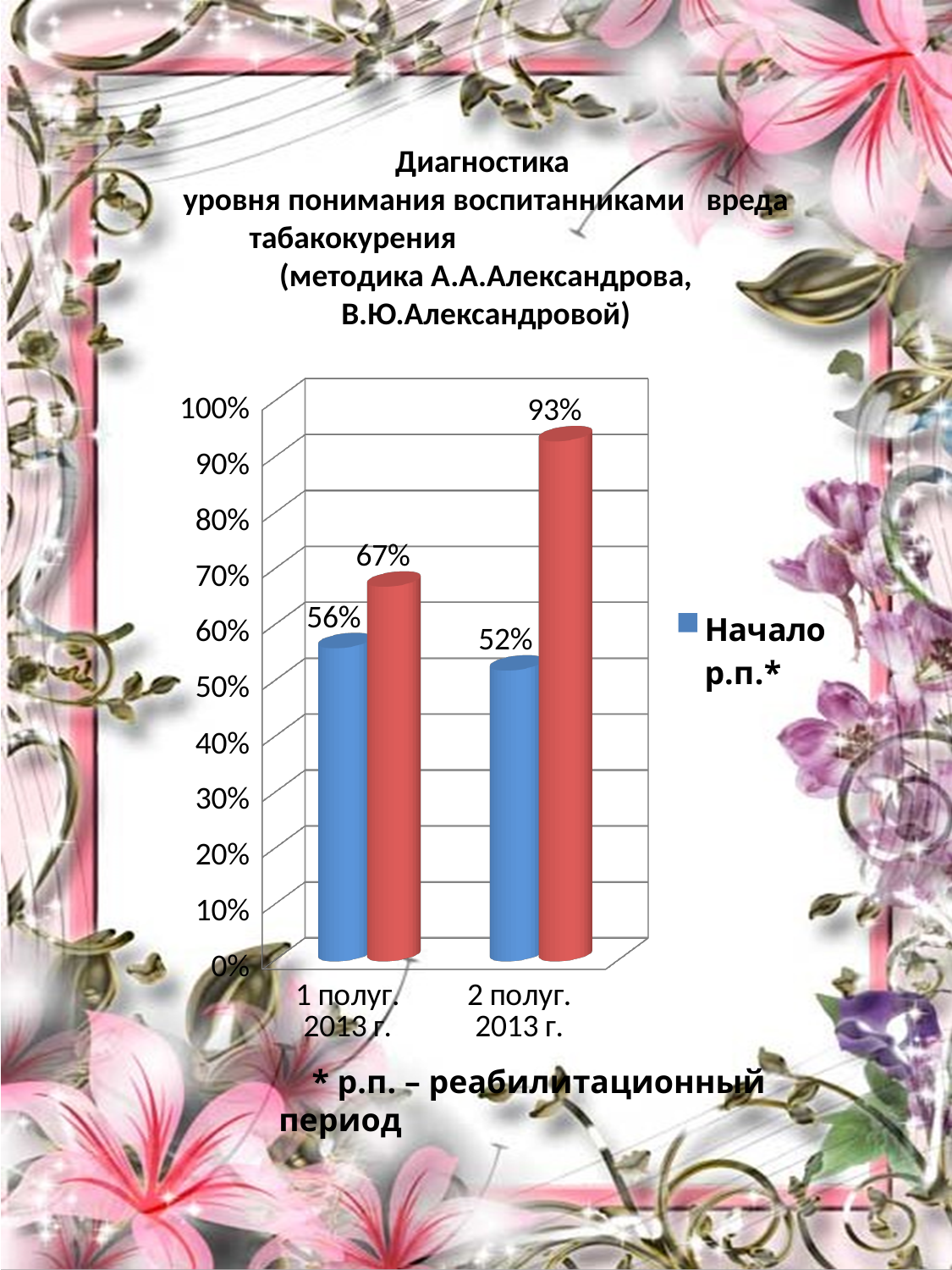
What kind of chart is shown on the slide? Bar chart What value is shown on the red bar for 2 полуг. 2013 г.? 93% What is the value of the Начало р.п.* series for 2 полуг. 2013 г.? 52% How many categories are shown on the x axis? 2 What is the lowest value shown on the chart? 52% For 2 полуг. 2013 г., how much higher is the red bar than the blue Начало р.п.* bar? 41 percentage points For the Начало р.п.* series, which period has the larger value: 1 полуг. 2013 г. or 2 полуг. 2013 г.? 1 полуг. 2013 г. What is the highest value shown on the chart? 93% For 1 полуг. 2013 г., what is the difference between the red bar and the blue Начало р.п.* bar? 11 percentage points What value is shown on the red bar for 1 полуг. 2013 г.? 67% What is the value of the Начало р.п.* series for 1 полуг. 2013 г.? 56% Does the Начало р.п.* series rise or fall from 1 полуг. 2013 г. to 2 полуг. 2013 г.? Falls